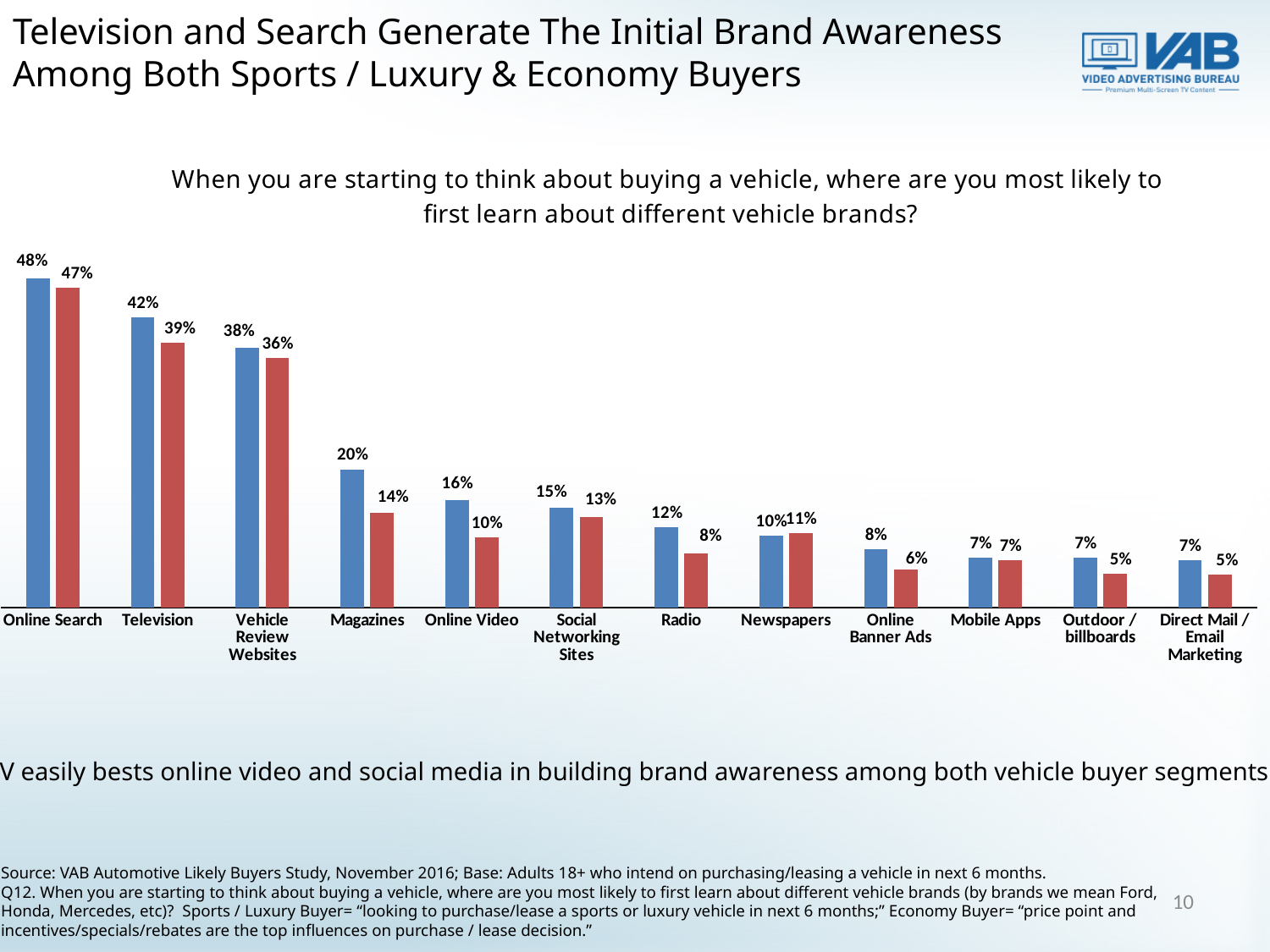
What is the value of the blue bar for Magazines? 20% How many categories are shown on the x axis of the chart? 12 What is the difference between the blue and red bars for Magazines? 6% Which category has the highest blue bar? Online Search What is the value of the blue bar for Online Search? 48% What is the difference between the blue bar for Television and the blue bar for Online Video? 26% What is the value of the red bar for Television? 39% Which is larger: the red bar for Radio or the red bar for Social Networking Sites? Social Networking Sites Which category has the lowest red bar value? Outdoor / billboards and Direct Mail / Email Marketing (5%) What is the value of the red bar for Online Video? 10% What type of chart is shown on the slide? bar chart For Newspapers, which bar is larger, the blue or the red? red